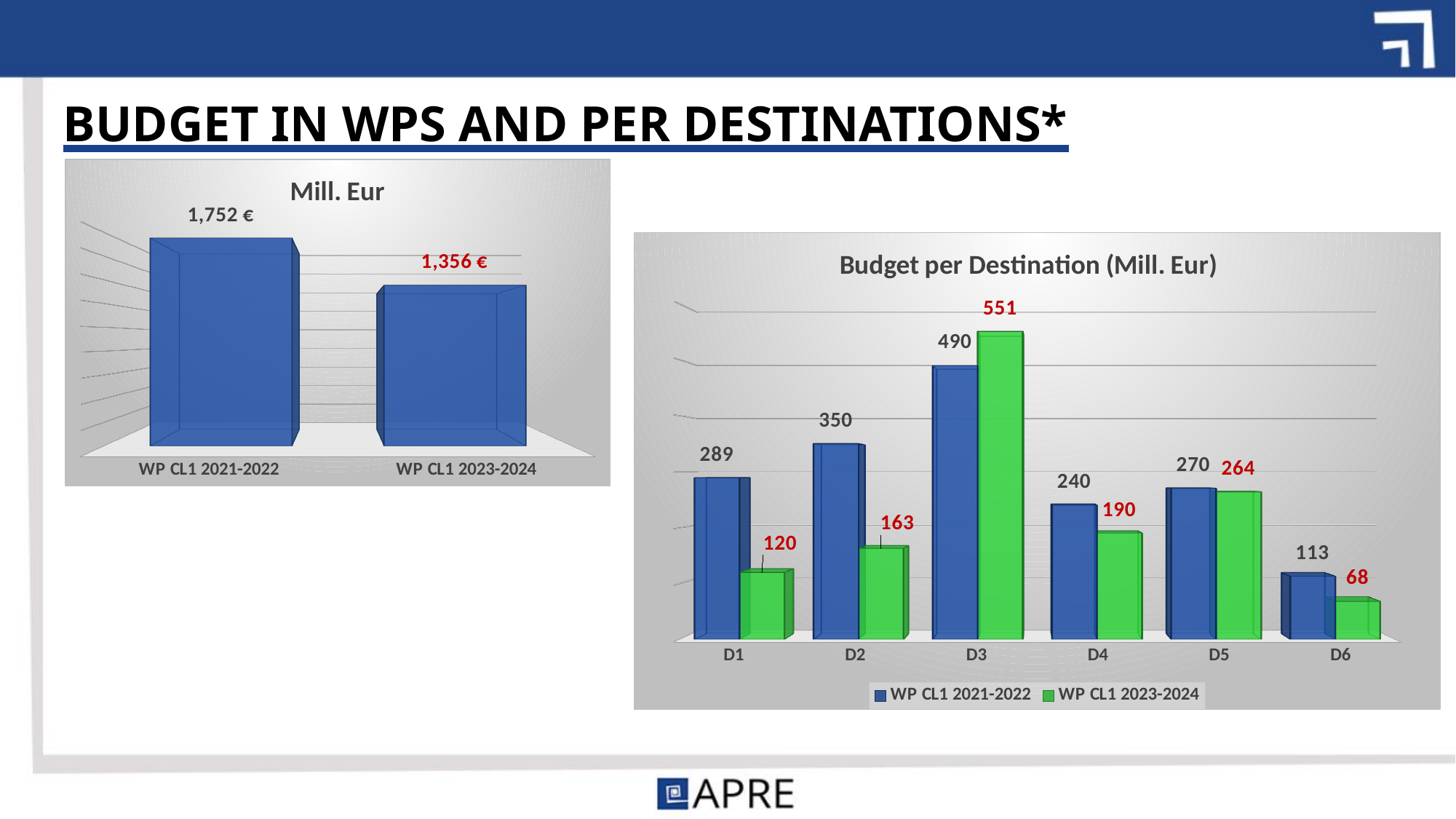
What kind of chart is the 'Budget per Destination (Mill. Eur)' chart? Bar chart In the 'Mill. Eur' chart, what is the value for WP CL1 2023-2024? 1,356 € In the 'Budget per Destination (Mill. Eur)' chart, which destination has the highest WP CL1 2021-2022 value? D3 In the 'Budget per Destination (Mill. Eur)' chart, which is larger for D5: the WP CL1 2021-2022 value or the WP CL1 2023-2024 value? WP CL1 2021-2022 In the 'Budget per Destination (Mill. Eur)' chart, how many destinations are shown on the x axis? 6 In the 'Budget per Destination (Mill. Eur)' chart, which destination has the lowest WP CL1 2023-2024 value? D6 In the 'Budget per Destination (Mill. Eur)' chart, what is the difference between the WP CL1 2021-2022 and WP CL1 2023-2024 values for D1? 169 In the 'Mill. Eur' chart, what is the difference between the WP CL1 2021-2022 and WP CL1 2023-2024 values? 396 € In the 'Budget per Destination (Mill. Eur)' chart, how many series does the legend list? 2 In the 'Budget per Destination (Mill. Eur)' chart, what is the WP CL1 2023-2024 value for D3? 551 In the 'Mill. Eur' chart, what is the value for WP CL1 2021-2022? 1,752 € In the 'Budget per Destination (Mill. Eur)' chart, what is the WP CL1 2021-2022 value for D4? 240